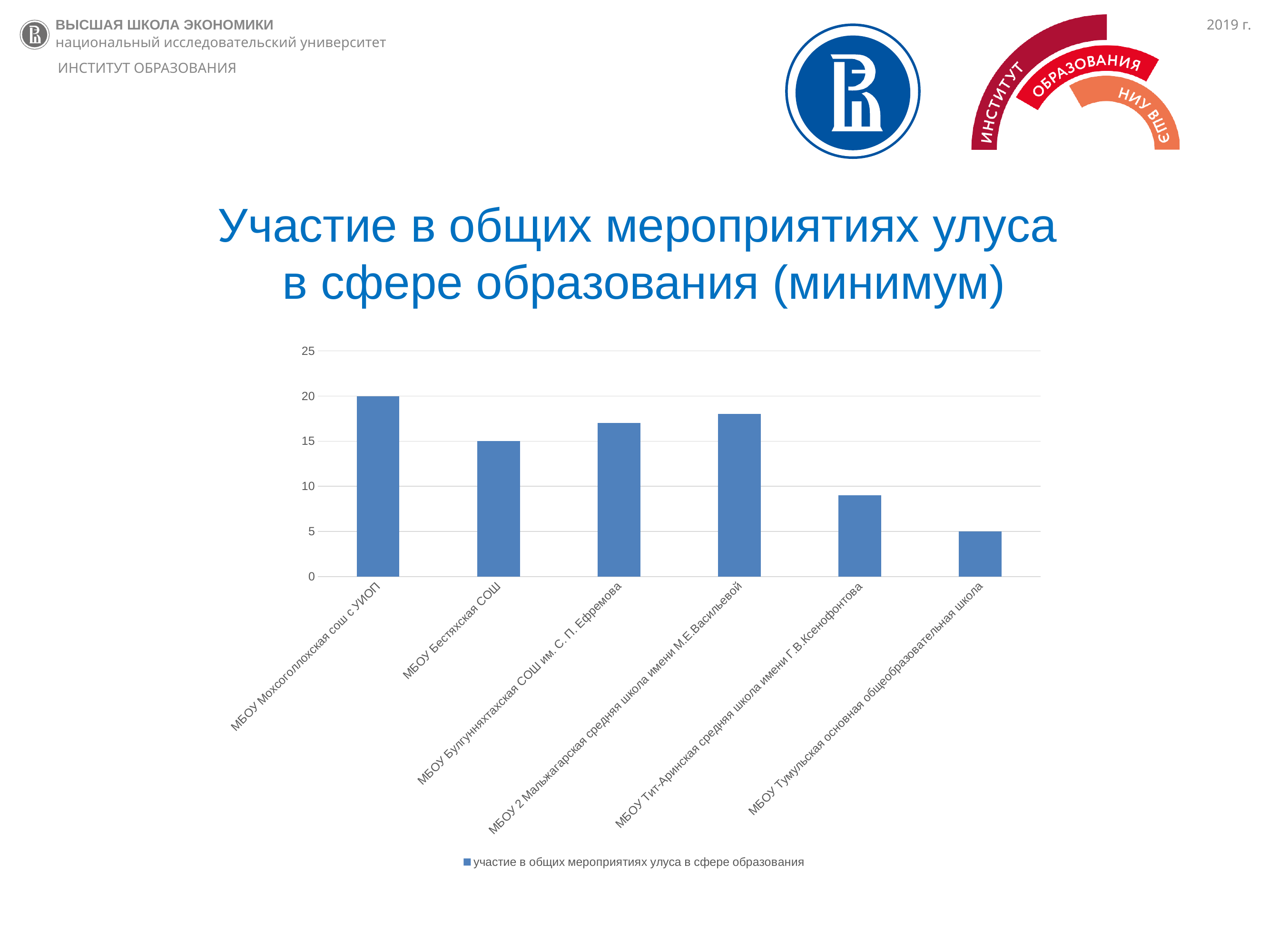
How many schools (categories) are shown on the x axis of the chart? 6 What kind of chart is shown on the slide? bar chart What is the legend entry of the chart? участие в общих мероприятиях улуса в сфере образования Is the value for МБОУ Тит-Аринская средняя школа имени Г.В.Ксенофонтова greater or less than 10? less What is the value for МБОУ Мохсоголлохская сош с УИОП? 20 Which school has the lowest value in the chart? МБОУ Тумульская основная общеобразовательная школа Is the value for МБОУ 2 Мальжагарская средняя школа имени М.Е.Васильевой greater or less than 15? greater Which has a larger value: МБОУ Булгунняхтахская СОШ им. С. П. Ефремова or МБОУ Тит-Аринская средняя школа имени Г.В.Ксенофонтова? МБОУ Булгунняхтахская СОШ им. С. П. Ефремова Which school has the highest value in the chart? МБОУ Мохсоголлохская сош с УИОП What is the value for МБОУ Тумульская основная общеобразовательная школа? 5 How many series does the chart legend list? 1 What is the value for МБОУ Бестяхская СОШ? 15